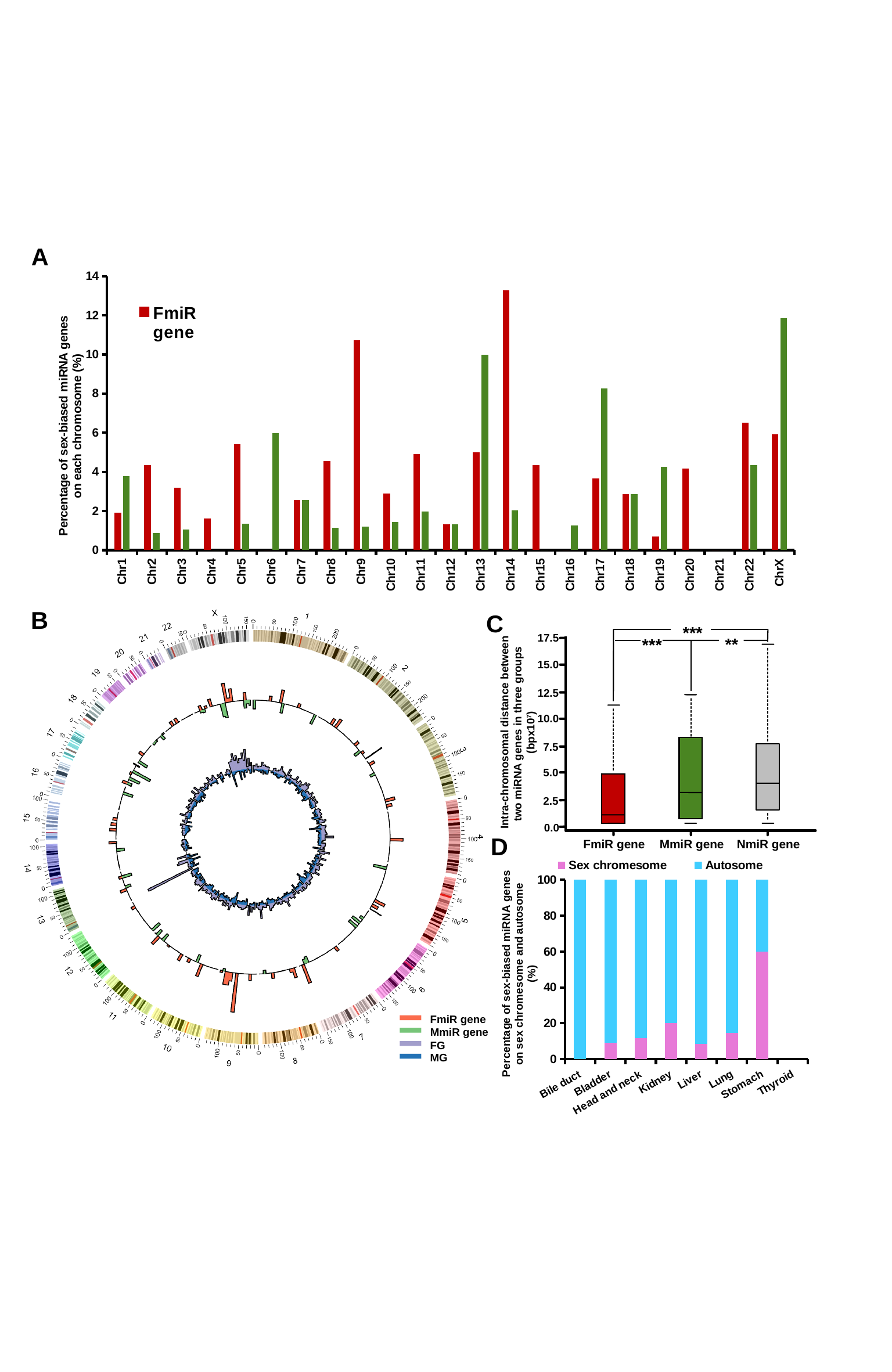
In panel C, which group has the lowest median intra-chromosomal distance? FmiR gene In panel A, is the red (FmiR gene) value for Chr9 greater or less than 10? greater In panel A, which chromosome has the highest red (FmiR gene) bar? Chr14 In panel D, which cancer type has the largest sex chromosome share? Stomach In panel A, how many chromosome categories are shown on the x axis? 23 In panel A, is the red (FmiR gene) value for Chr5 greater or less than 4? greater In panel A, for Chr9, which bar is taller, the red bar or the green bar? the red bar In panel D, is the sex chromosome value for Stomach greater or less than 40? greater In panel A, which chromosome has the tallest green bar? ChrX In panel D, how many series does the legend list? 2 What kind of chart is panel C? box plot In panel A, for Chr13, which bar is taller, the red bar or the green bar? the green bar